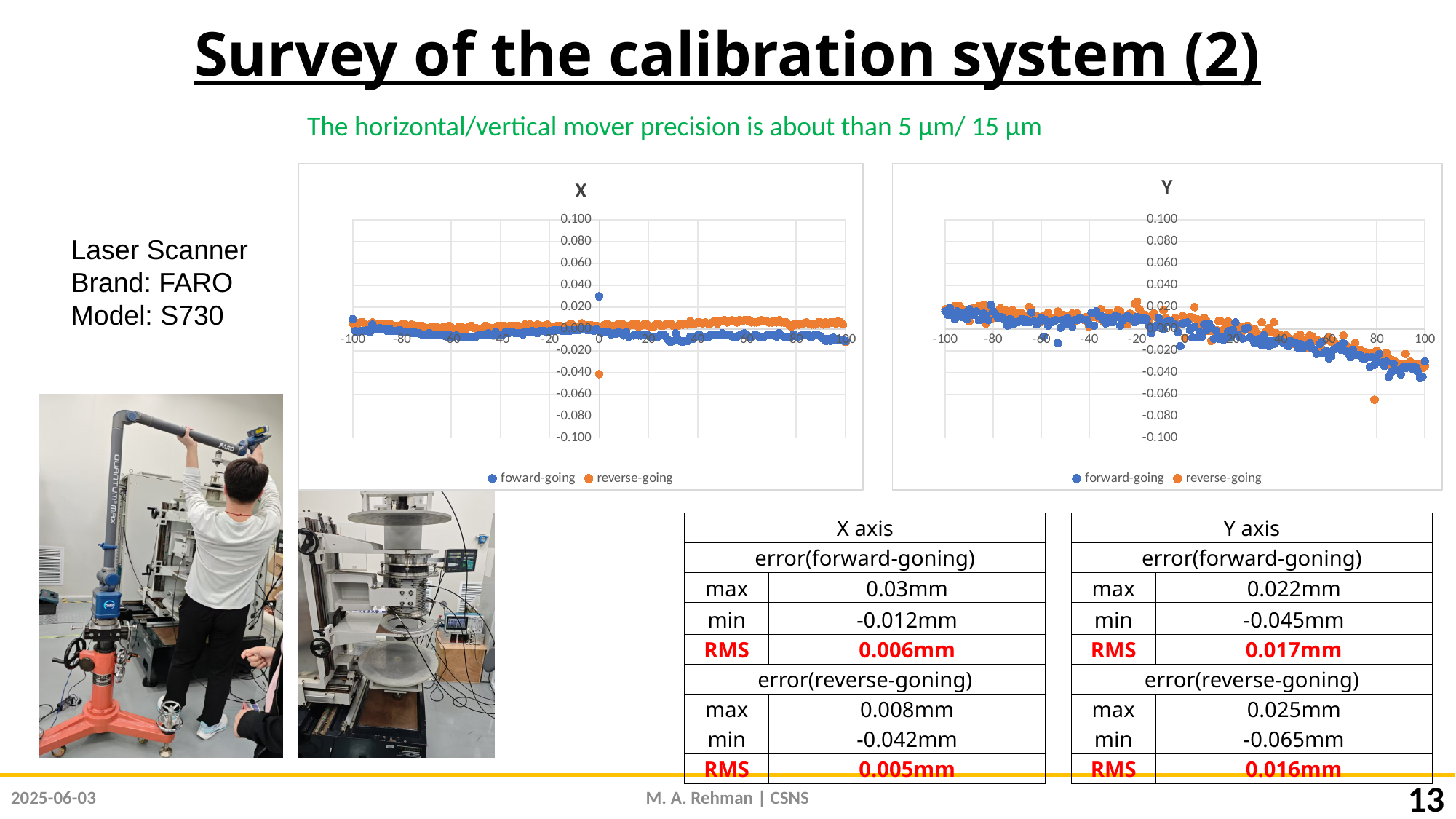
In the chart titled Y, do the forward-going values rise or fall as the x axis goes from -100 to 100? fall What are the legend entries of the chart titled Y? forward-going, reverse-going How many charts are shown on the slide? 2 In the chart titled Y, is the reverse-going value at x = -100 greater or less than 0.000? greater How many series does the legend of the chart titled X list? 2 In the chart titled X, is the highest forward-going point greater or less than 0.020? greater What kind of chart is the chart titled X? scatter chart In the chart titled X, is the lowest reverse-going point greater or less than -0.020? less In the chart titled Y, which is larger: the forward-going value at x = -100 or at x = 100? at x = -100 How many series does the legend of the chart titled Y list? 2 What is the highest value shown on the vertical axis of the chart titled X? 0.100